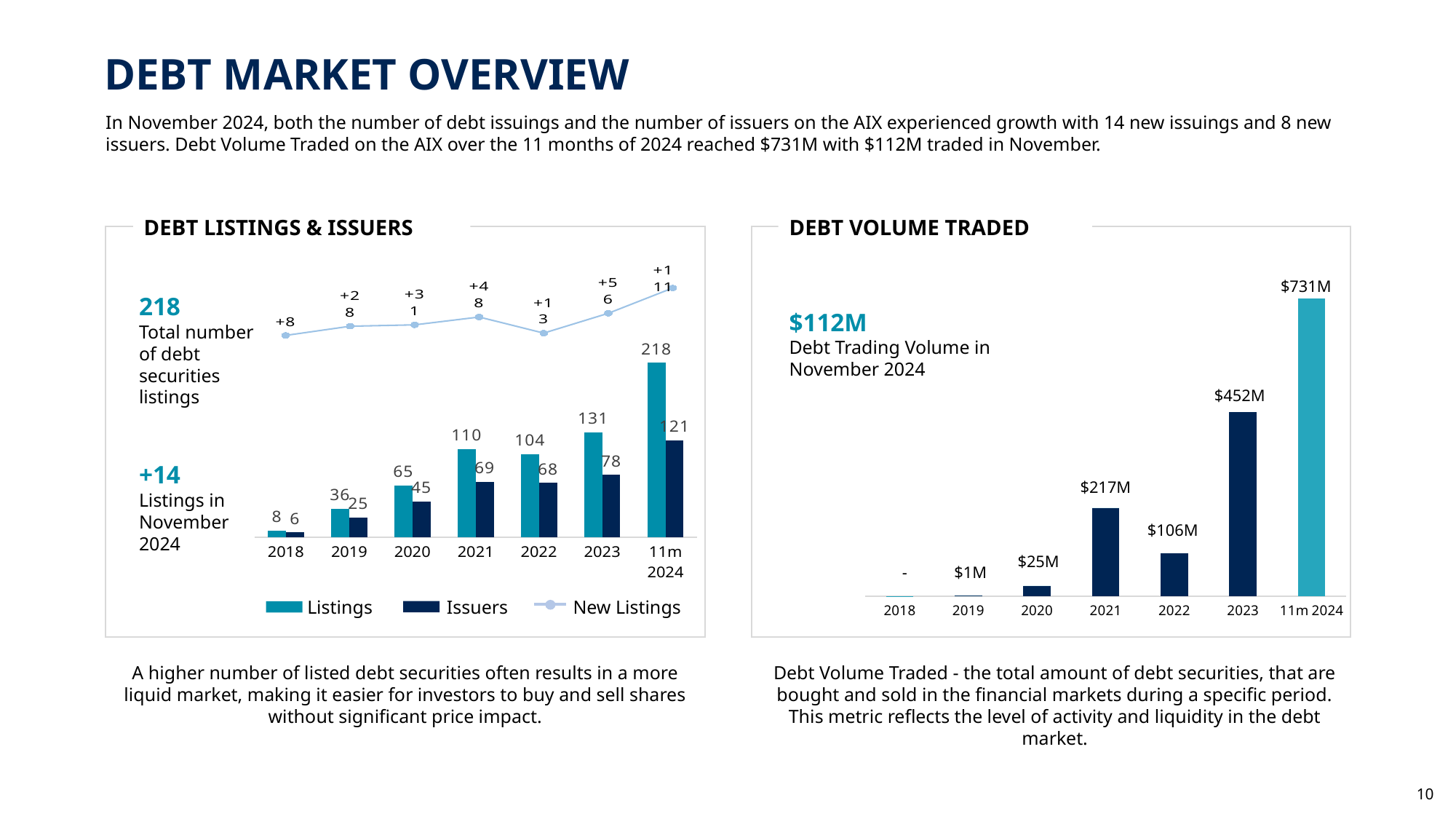
In the DEBT LISTINGS & ISSUERS chart, what is the New Listings value for 2023? +56 In the DEBT LISTINGS & ISSUERS chart, what is the Listings value for 2021? 110 How many periods are shown on the x axis of the DEBT VOLUME TRADED chart? 7 In the DEBT LISTINGS & ISSUERS chart, what is the difference between Listings and Issuers for 11m 2024? 97 In the DEBT VOLUME TRADED chart, which period has the highest value? 11m 2024 In the DEBT LISTINGS & ISSUERS chart, which period has the highest Listings value? 11m 2024 In the DEBT LISTINGS & ISSUERS chart, what is the Issuers value for 2023? 78 In the DEBT LISTINGS & ISSUERS chart, which is larger: Listings in 2021 or Listings in 2022? Listings in 2021 What kind of chart is the DEBT VOLUME TRADED chart? Bar chart How many series does the legend of the DEBT LISTINGS & ISSUERS chart list? 3 In the DEBT VOLUME TRADED chart, what is the difference between the 2023 and 2022 values? $346M In the DEBT VOLUME TRADED chart, what is the value for 2021? $217M